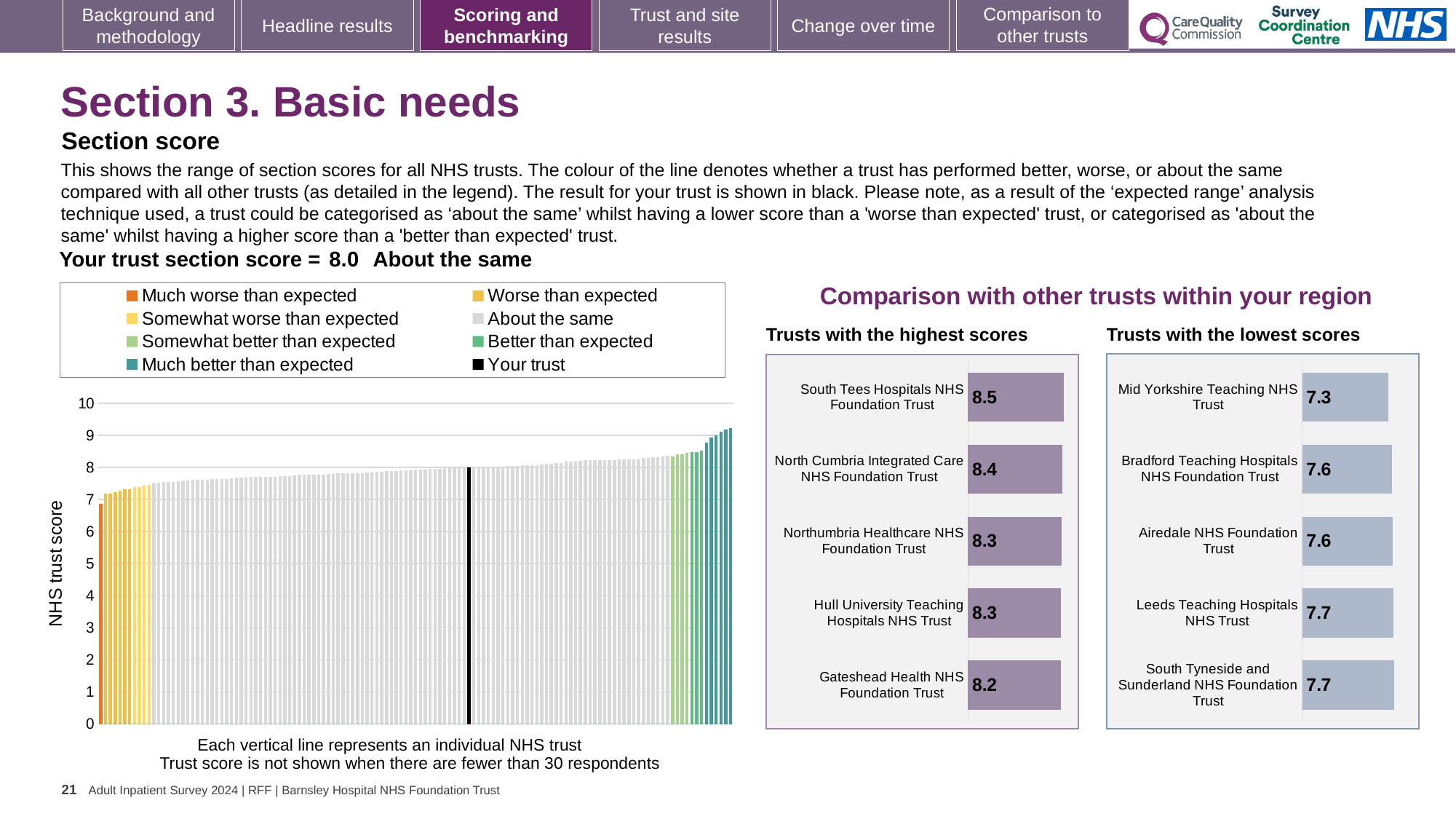
What kind of chart is the 'Trusts with the highest scores' chart? Bar chart How many trusts are shown in the 'Trusts with the lowest scores' chart? 5 In the 'Trusts with the highest scores' chart, what is the score for Gateshead Health NHS Foundation Trust? 8.2 In the 'Trusts with the lowest scores' chart, what is the difference between the scores of Leeds Teaching Hospitals NHS Trust and Mid Yorkshire Teaching NHS Trust? 0.4 In the 'Trusts with the highest scores' chart, what is the score for South Tees Hospitals NHS Foundation Trust? 8.5 How many entries does the legend of the NHS trust score chart on the left list? 8 In the 'Trusts with the highest scores' chart, which has the larger score: North Cumbria Integrated Care NHS Foundation Trust or Northumbria Healthcare NHS Foundation Trust? North Cumbria Integrated Care NHS Foundation Trust In the 'Trusts with the lowest scores' chart, what is the score for Mid Yorkshire Teaching NHS Trust? 7.3 In the 'Trusts with the lowest scores' chart, which trust has the lowest score? Mid Yorkshire Teaching NHS Trust In the 'Trusts with the lowest scores' chart, what is the score for Leeds Teaching Hospitals NHS Trust? 7.7 In the 'Trusts with the highest scores' chart, which trust has the highest score? South Tees Hospitals NHS Foundation Trust In the 'Trusts with the highest scores' chart, what is the difference between the scores of South Tees Hospitals NHS Foundation Trust and Gateshead Health NHS Foundation Trust? 0.3